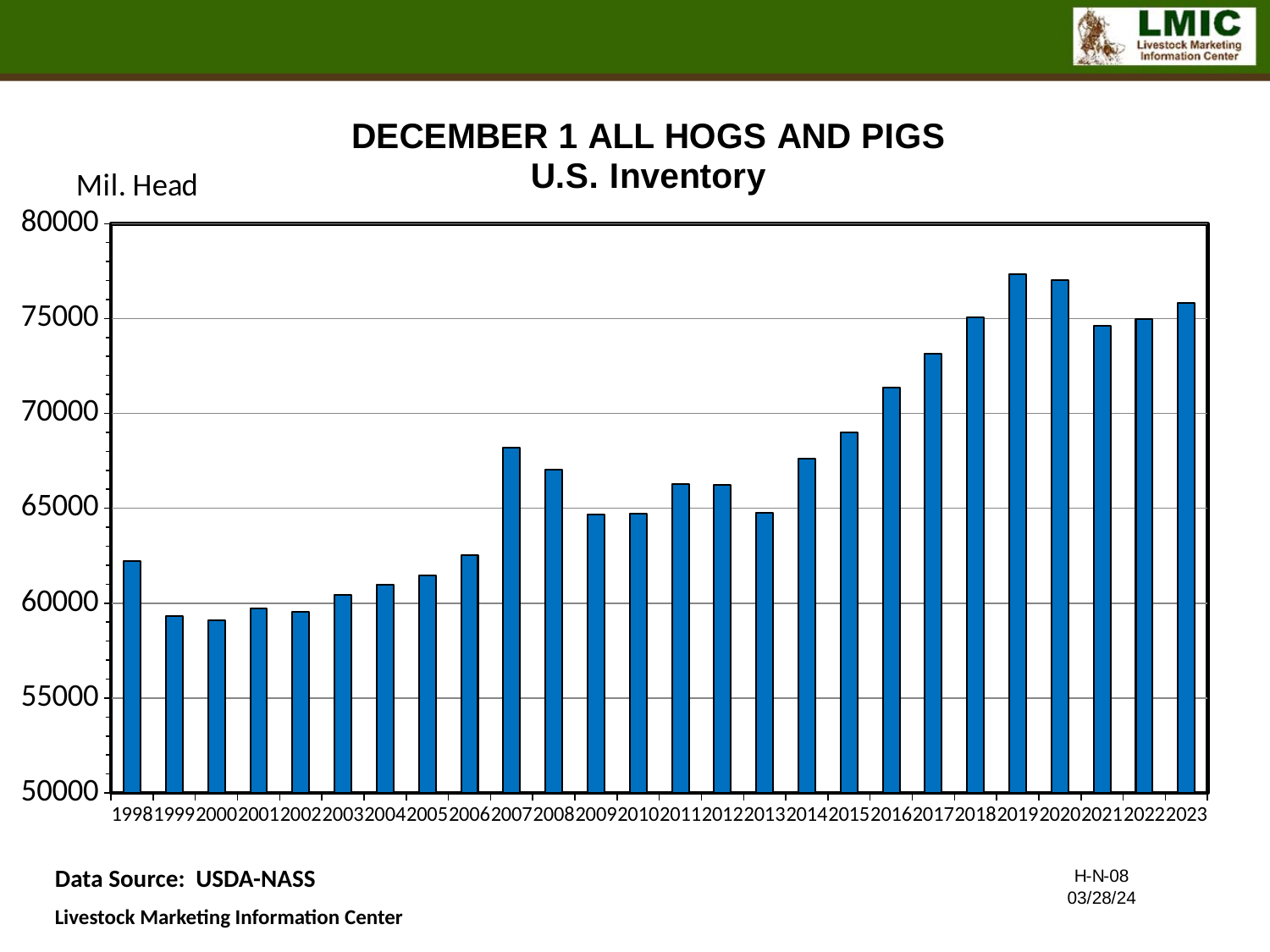
Which year has a larger value, 2006 or 2007? 2007 What unit label is shown above the y axis of the chart? Mil. Head Is the value for 2009 greater or less than 65000? less Is the value for 2019 greater or less than 75000? greater Is the value for 2000 greater or less than 60000? less Which year has a larger value, 2012 or 2016? 2016 Do the values rise or fall from 2013 to 2019? rise How many years are plotted on the x axis of the chart? 26 What kind of chart is shown on the slide? bar chart